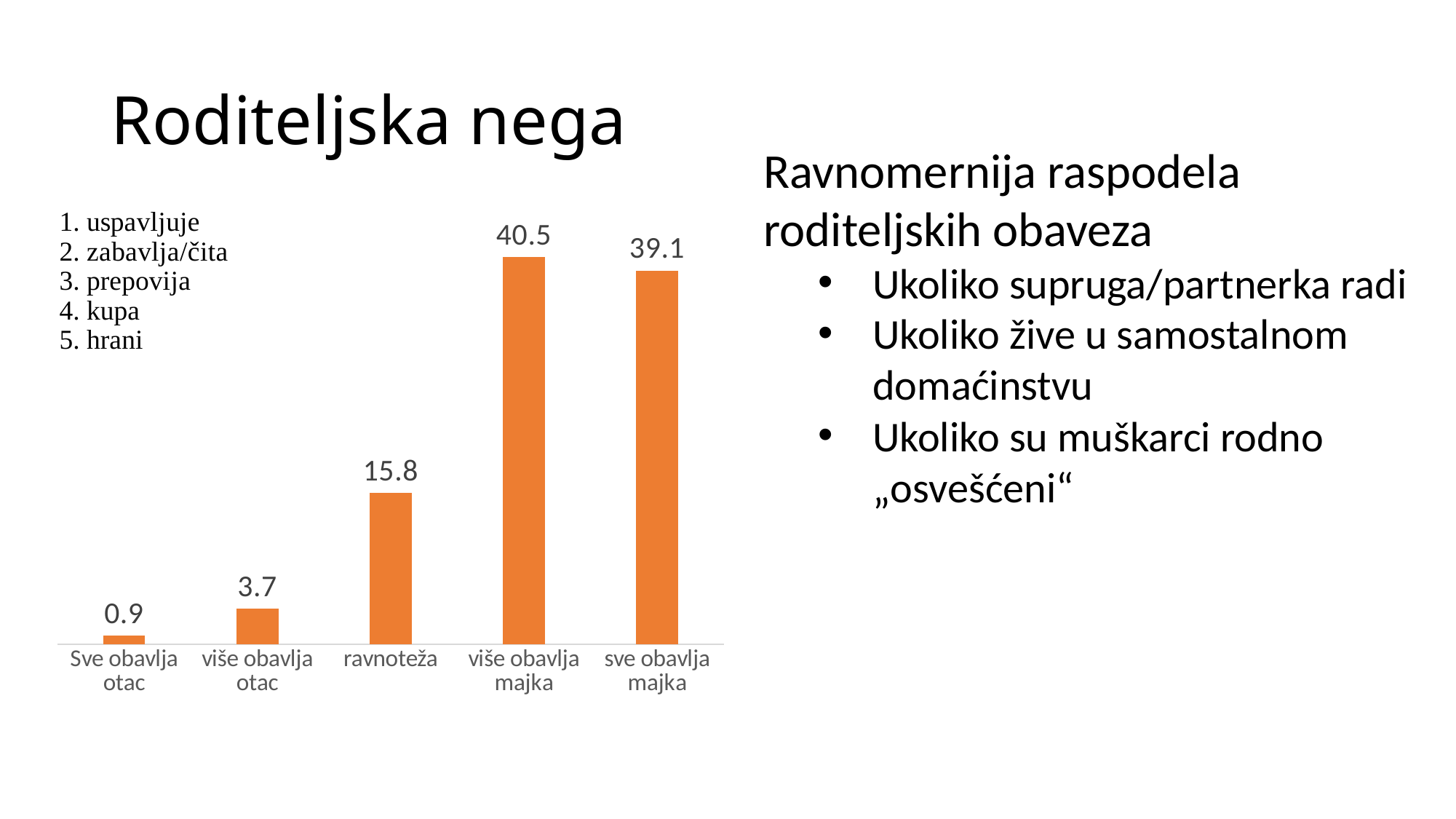
What colour are the bars in the chart? orange What is the value for "sve obavlja majka"? 39.1 What is the value for "više obavlja majka"? 40.5 What is the value for "Sve obavlja otac"? 0.9 Which category has the lowest value? Sve obavlja otac What is the difference between the values for "više obavlja majka" and "sve obavlja majka"? 1.4 How many categories are shown on the x axis of the chart? 5 Which category has the highest value? više obavlja majka What is the difference between the values for "ravnoteža" and "više obavlja otac"? 12.1 What is the value for "ravnoteža"? 15.8 What kind of chart is shown on the slide? bar chart Which is larger, the value for "više obavlja otac" or the value for "ravnoteža"? ravnoteža